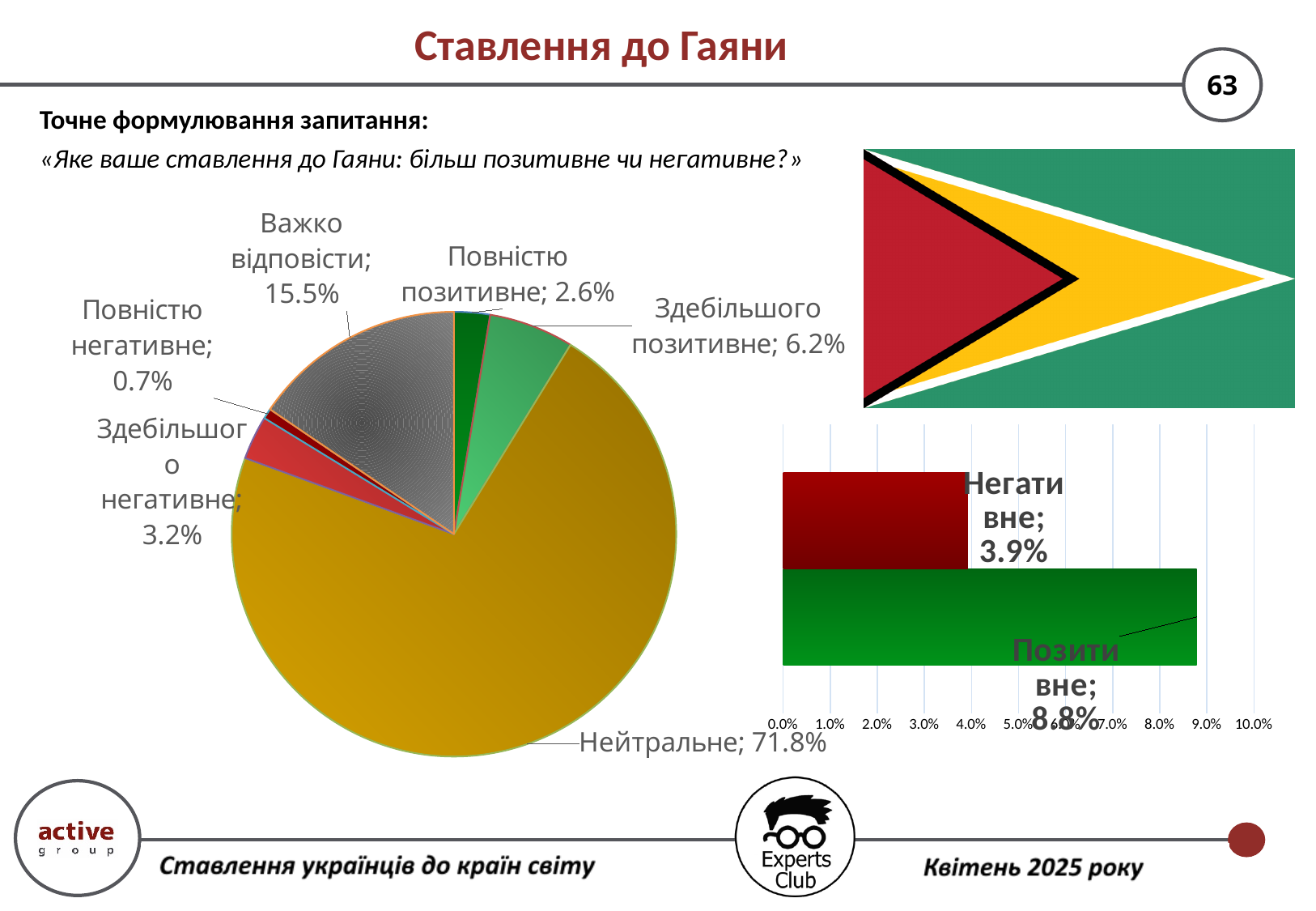
In the pie chart, what is the value for "Важко відповісти"? 15.5% In the bar chart on the right, what is the value for "Позитивне"? 8.8% In the bar chart on the right, what is the difference between "Позитивне" and "Негативне"? 4.9% In the pie chart, what is the value for "Здебільшого позитивне"? 6.2% In the pie chart, what is the difference between "Здебільшого позитивне" and "Повністю позитивне"? 3.6% In the pie chart, which category has the smallest slice? Повністю негативне What type of chart is shown on the right side of the slide below the flag? Bar chart In the pie chart, what share is labelled for "Нейтральне"? 71.8% In the pie chart, which category has the largest slice? Нейтральне In the pie chart, how many categories are shown? 6 In the pie chart, what is the value for "Повністю негативне"? 0.7% In the pie chart, which is larger: "Здебільшого негативне" or "Повністю позитивне"? Здебільшого негативне